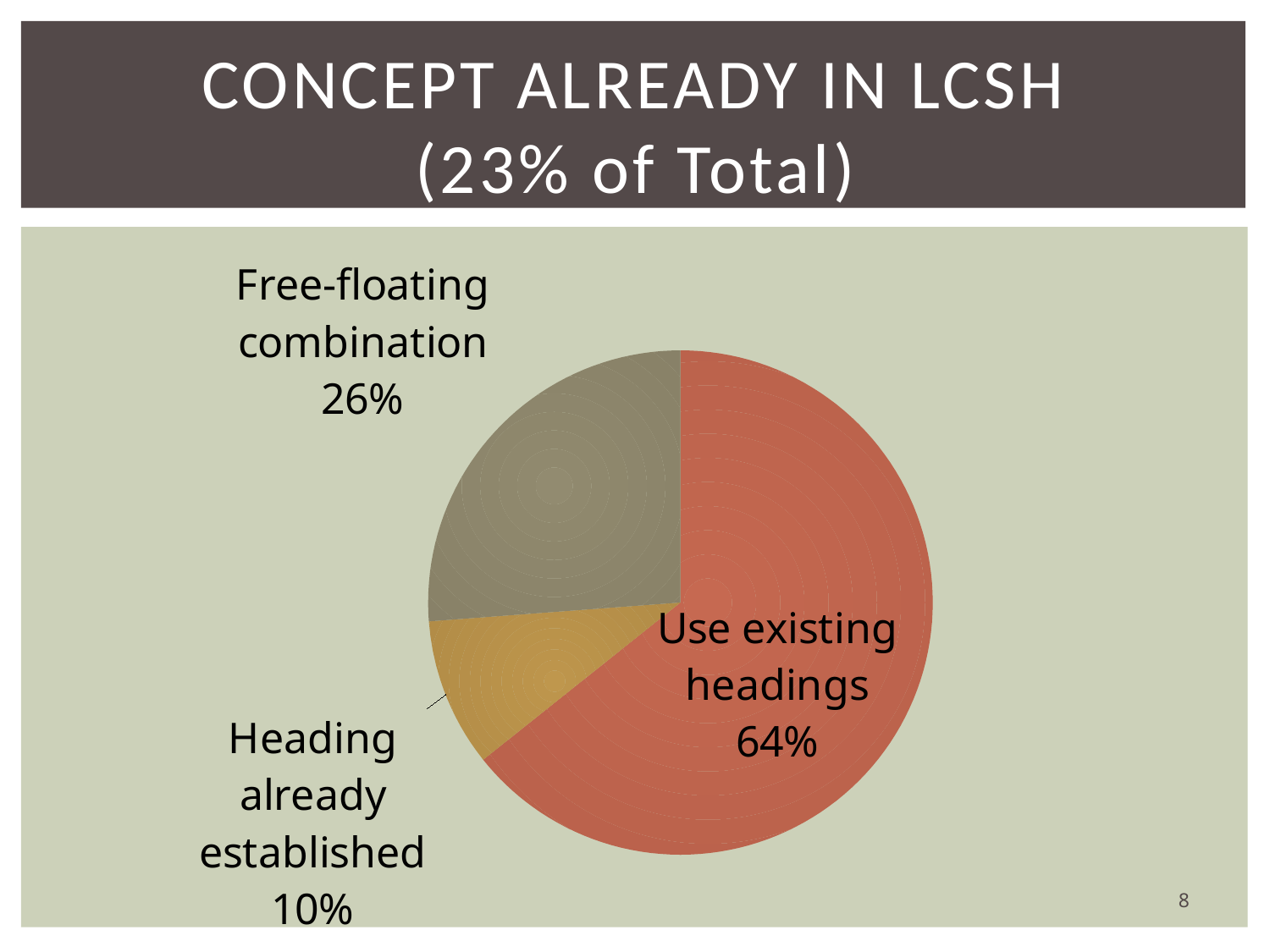
What is the title of the slide containing the pie chart? CONCEPT ALREADY IN LCSH (23% of Total) Which slice of the pie is the largest? Use existing headings How many slices does the pie chart have? 3 What share of the pie does "Use existing headings" represent? 64% What share of the pie does "Free-floating combination" represent? 26% What is the difference in percentage points between "Free-floating combination" and "Heading already established"? 16 What kind of chart is shown on the slide? pie chart What share of the pie does "Heading already established" represent? 10% Which is larger, the share for "Free-floating combination" or the share for "Heading already established"? Free-floating combination Which slice of the pie is the smallest? Heading already established What colour is the "Use existing headings" slice? red What is the difference in percentage points between "Use existing headings" and "Free-floating combination"? 38